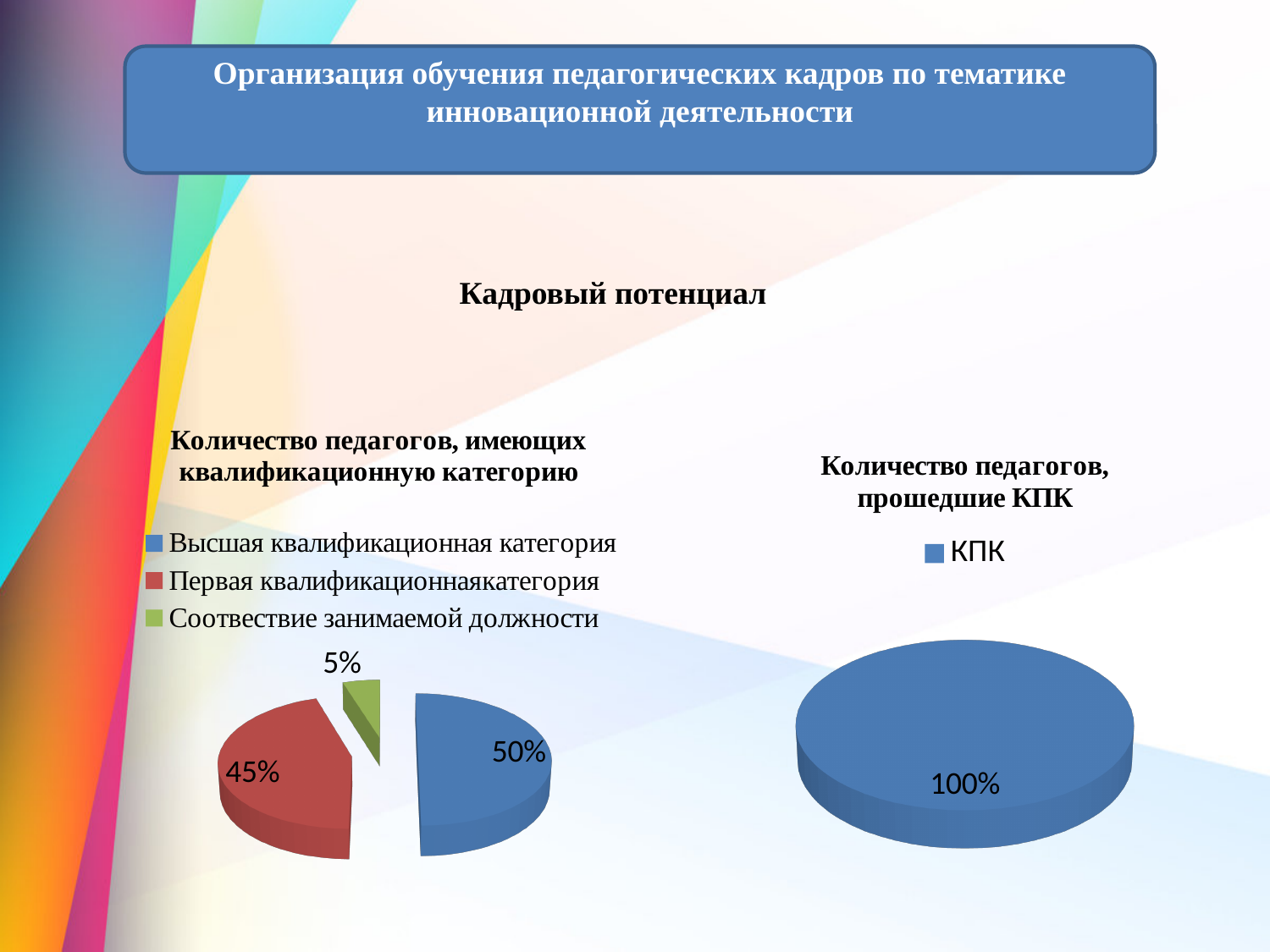
In the right chart (Количество педагогов, прошедшие КПК), what is the value for КПК? 100% In the left chart (Количество педагогов, имеющих квалификационную категорию), which category has the smallest share? Соотвествие занимаемой должности In the left chart (Количество педагогов, имеющих квалификационную категорию), what is the value for Высшая квалификационная категория? 50% In the left chart (Количество педагогов, имеющих квалификационную категорию), what is the difference between the shares for Первая квалификационная категория and Соотвествие занимаемой должности? 40% What kind of chart is the left chart (Количество педагогов, имеющих квалификационную категорию)? Pie chart In the left chart (Количество педагогов, имеющих квалификационную категорию), what is the value for Первая квалификационная категория? 45% In the left chart (Количество педагогов, имеющих квалификационную категорию), which is larger: Высшая квалификационная категория or Первая квалификационная категория? Высшая квалификационная категория In the left chart (Количество педагогов, имеющих квалификационную категорию), which category has the largest share? Высшая квалификационная категория How many entries does the legend of the right chart (Количество педагогов, прошедшие КПК) list? 1 What is the title of the right chart? Количество педагогов, прошедшие КПК In the left chart (Количество педагогов, имеющих квалификационную категорию), what is the value for Соотвествие занимаемой должности? 5% How many categories does the left chart (Количество педагогов, имеющих квалификационную категорию) show? 3